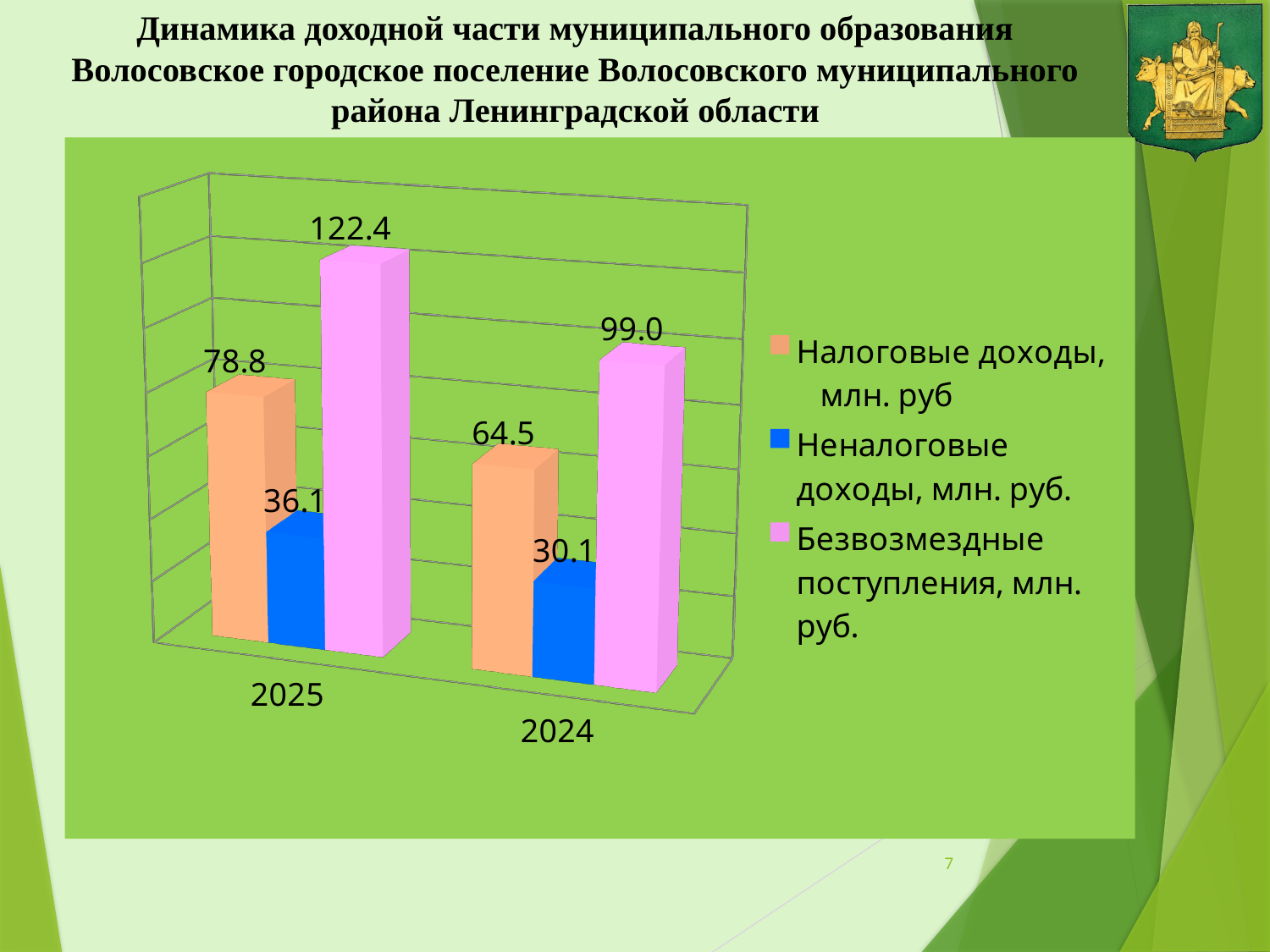
What is the value of Неналоговые доходы, млн. руб. for 2025? 36.1 What is the difference between Налоговые доходы in 2025 and in 2024? 14.3 What is the value of Налоговые доходы, млн. руб for 2024? 64.5 What is the value of Налоговые доходы, млн. руб for 2025? 78.8 Which is larger: Неналоговые доходы in 2025 or in 2024? 2025 What kind of chart is shown on the slide? Bar chart What is the value of Безвозмездные поступления, млн. руб. for 2024? 99.0 How many series does the legend list? 3 Which series has the highest value in 2025? Безвозмездные поступления, млн. руб. How many categories (years) are shown on the x axis? 2 Which series has the lowest value in 2024? Неналоговые доходы, млн. руб. What is the difference between Безвозмездные поступления in 2025 and in 2024? 23.4